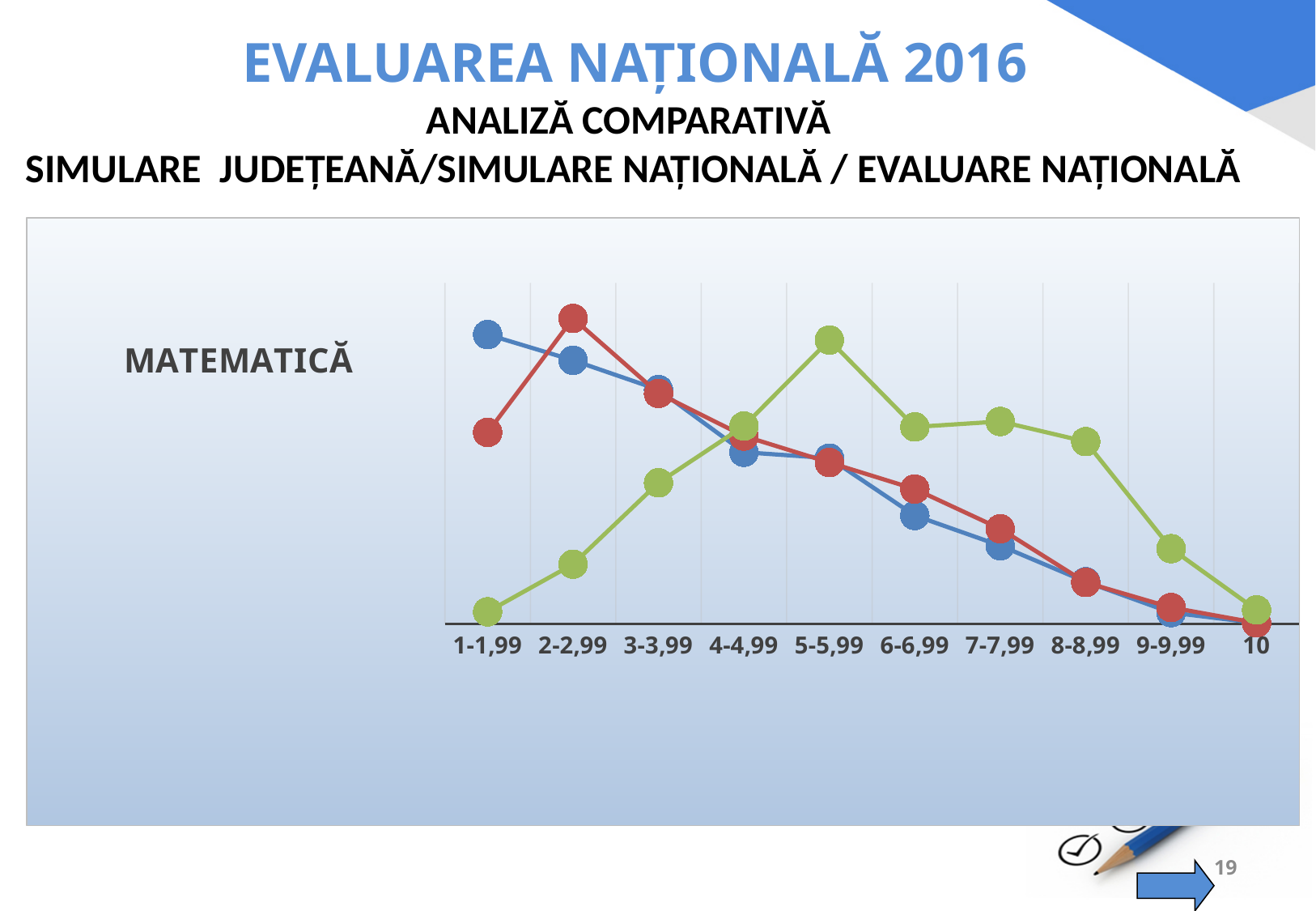
At the category 1-1,99, which line is higher: the blue line or the green line? blue line At which x-axis category does the green line reach its highest point? 5-5,99 How many categories are shown on the x axis of the chart? 10 At the category 8-8,99, which line is higher: the green line or the red line? green line At which x-axis category does the blue line reach its highest point? 1-1,99 What kind of chart is shown on the slide? line chart At which x-axis category does the red line reach its highest point? 2-2,99 How many lines (series) are plotted on the chart? 3 At which x-axis category does the green line have its lowest point? 1-1,99 Does the green line rise or fall from 1-1,99 to 5-5,99? rise What subject label is written to the left of the chart? MATEMATICĂ At the category 2-2,99, which line is higher: the red line or the blue line? red line